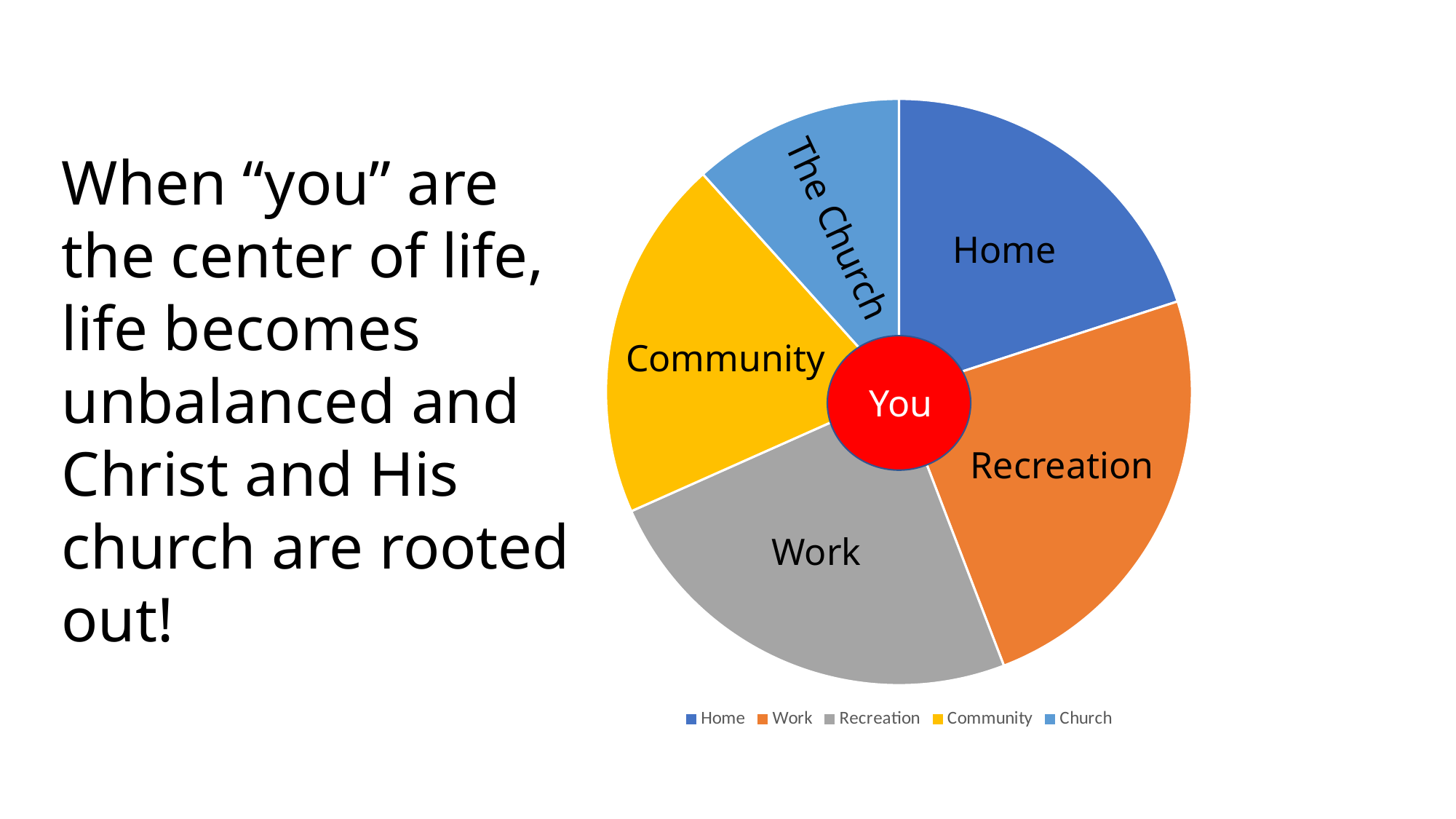
Which slice is larger, Work or The Church? Work What word is written in the red circle at the center of the pie chart? You Which slice is larger, Home or The Church? Home How many slices does the pie chart have? 5 Which slice of the pie chart is the smallest? The Church What kind of chart is shown on the slide? pie chart Which slice is larger, Community or The Church? Community How many entries does the legend of the pie chart list? 5 What colour is the Home slice of the pie chart? blue